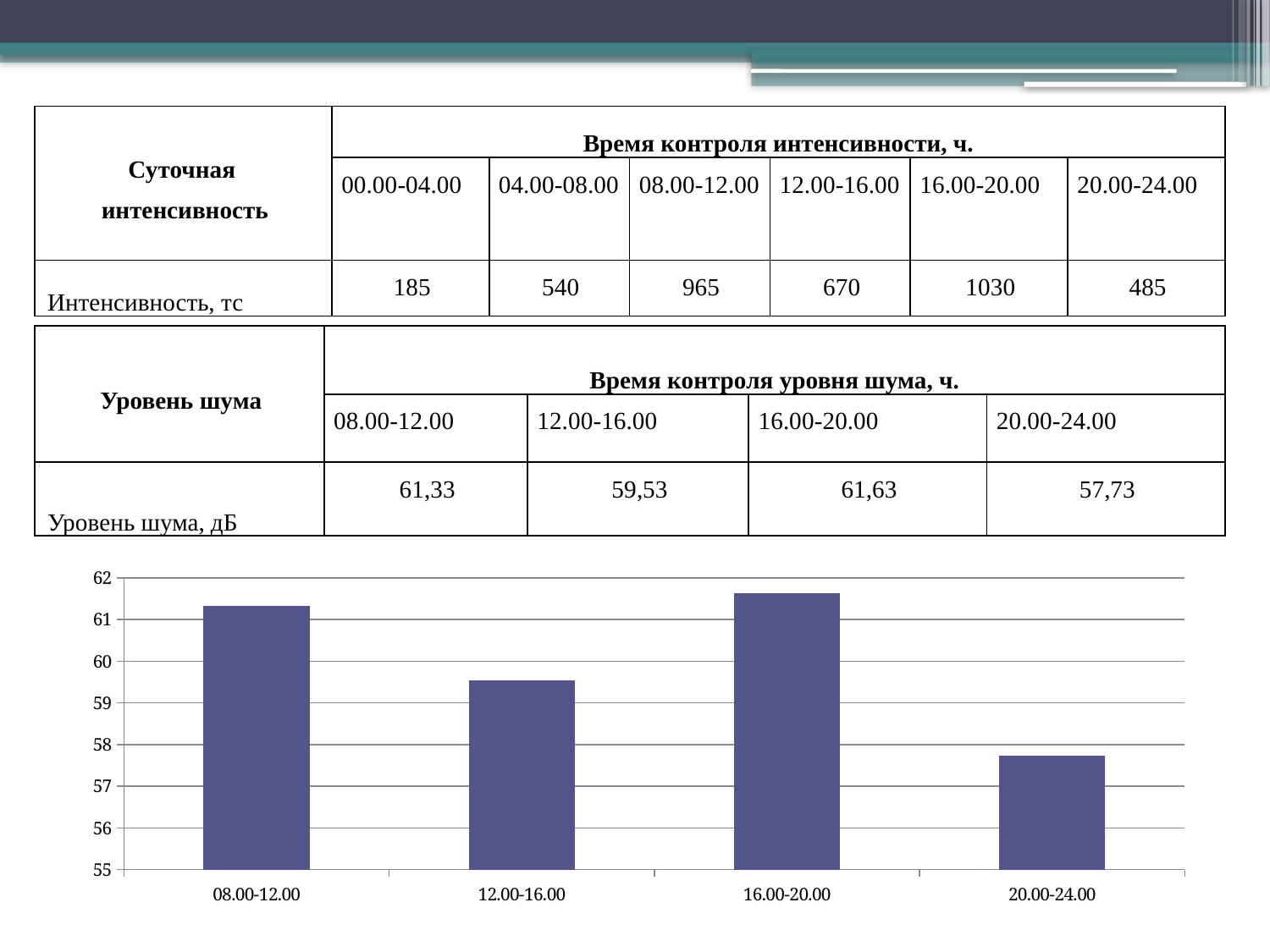
Is the value for 08.00-12.00 in the chart greater or less than 61? greater Which time interval has the highest bar in the chart? 16.00-20.00 Which time interval has the lowest bar in the chart? 20.00-24.00 According to the noise level table, what is the noise level (дБ) for 20.00-24.00 plotted in the chart? 57,73 How many bars (time intervals) does the chart show? 4 What kind of chart is shown at the bottom of the slide? bar chart What is the lowest value shown on the chart's vertical axis? 55 Is the value for 20.00-24.00 in the chart greater or less than 58? less Which is larger in the chart, the bar for 08.00-12.00 or the bar for 12.00-16.00? 08.00-12.00 Is the value for 12.00-16.00 in the chart greater or less than 60? less Using the values in the noise level table, what is the difference between the noise level for 16.00-20.00 and for 20.00-24.00? 3,9 According to the noise level table, what is the noise level (дБ) for 16.00-20.00 plotted in the chart? 61,63